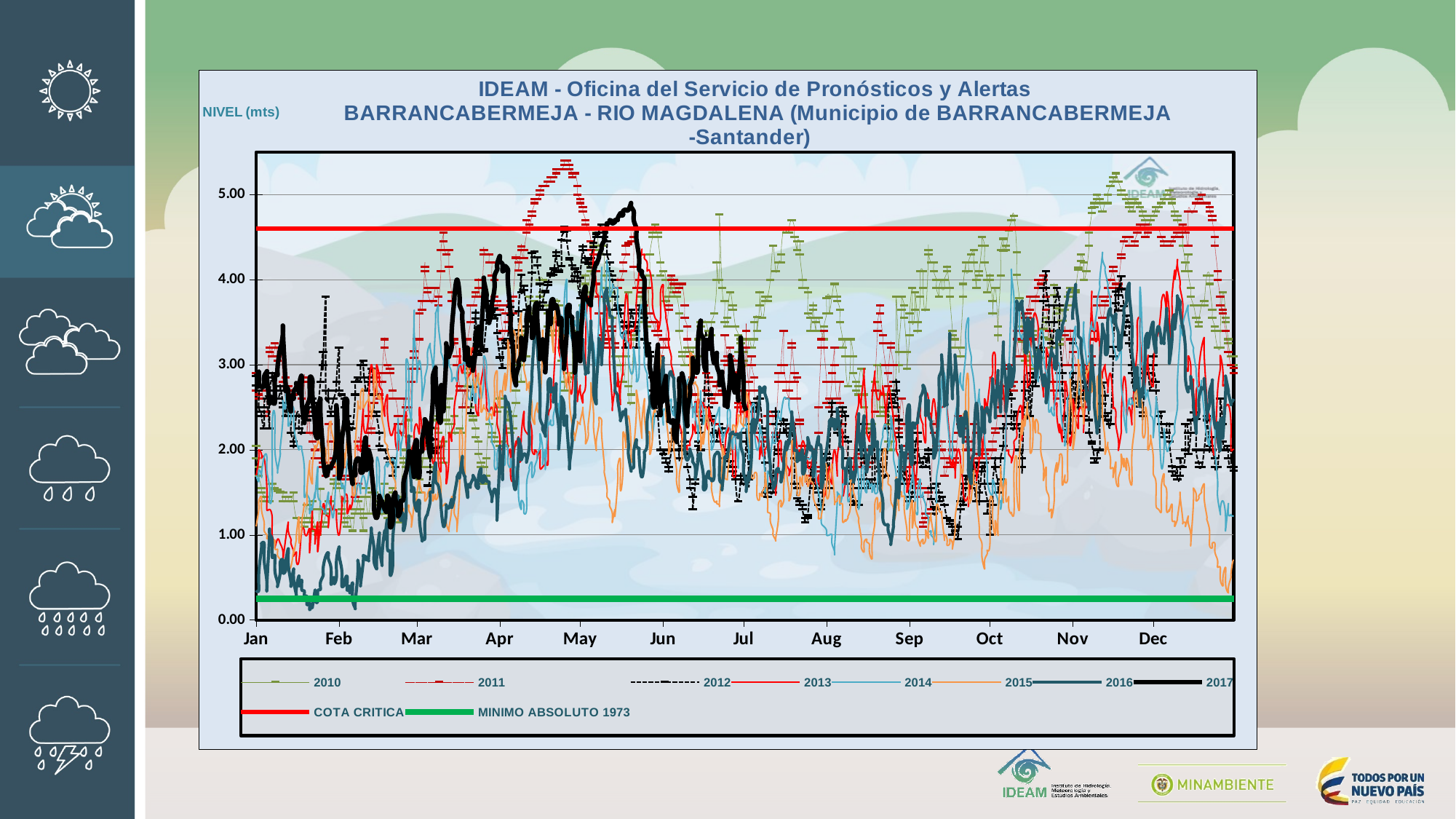
Is the peak value of the 2017 series in late May greater or less than 4.00? greater Is the value of the 2015 series at the end of December greater or less than 1.00? less What kind of chart is shown on the slide? line chart Is the COTA CRITICA line greater or less than 4.00? greater How many entries does the chart legend list? 10 Which legend entry is drawn as a thick red horizontal line? COTA CRITICA How many months are labelled along the x axis? 12 Which is larger, the COTA CRITICA line or the MINIMO ABSOLUTO 1973 line? COTA CRITICA What is the label of the y axis? NIVEL (mts)